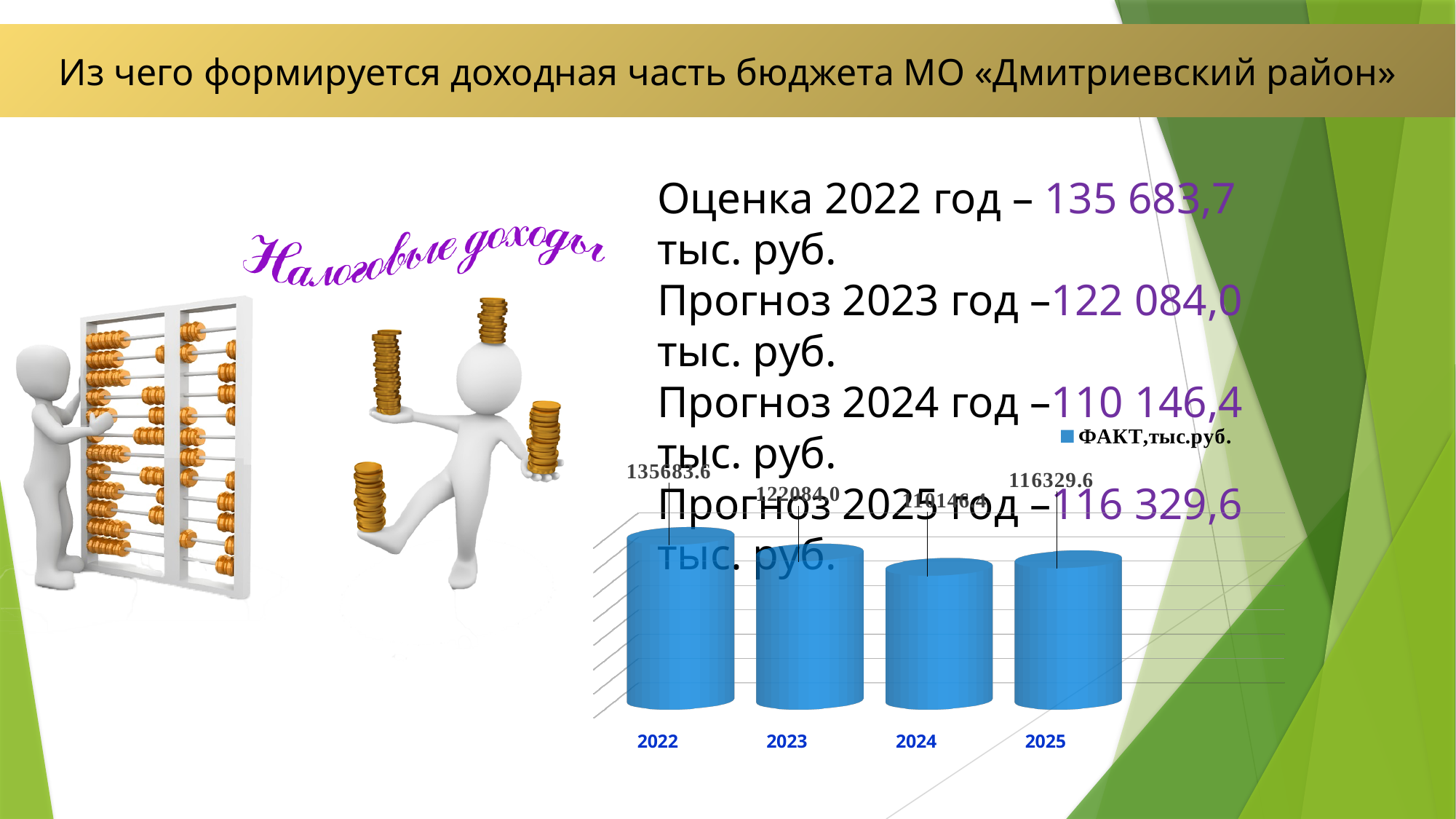
What is the legend entry of the chart? ФАКТ,тыс.руб. What is the value for 2025 in the chart? 116329.6 What is the difference between the values for 2022 and 2023 in the chart? 13599.6 Which is larger in the chart, the value for 2024 or the value for 2025? 2025 Which year has the highest value in the chart? 2022 How many series does the chart's legend list? 1 How many years are shown on the x axis of the chart? 4 What is the value for 2022 in the chart? 135683.6 What is the value for 2023 in the chart? 122084.0 What kind of chart is shown on the slide? bar chart Do the values in the chart rise or fall from 2022 to 2024? fall Which year has the lowest value in the chart? 2024